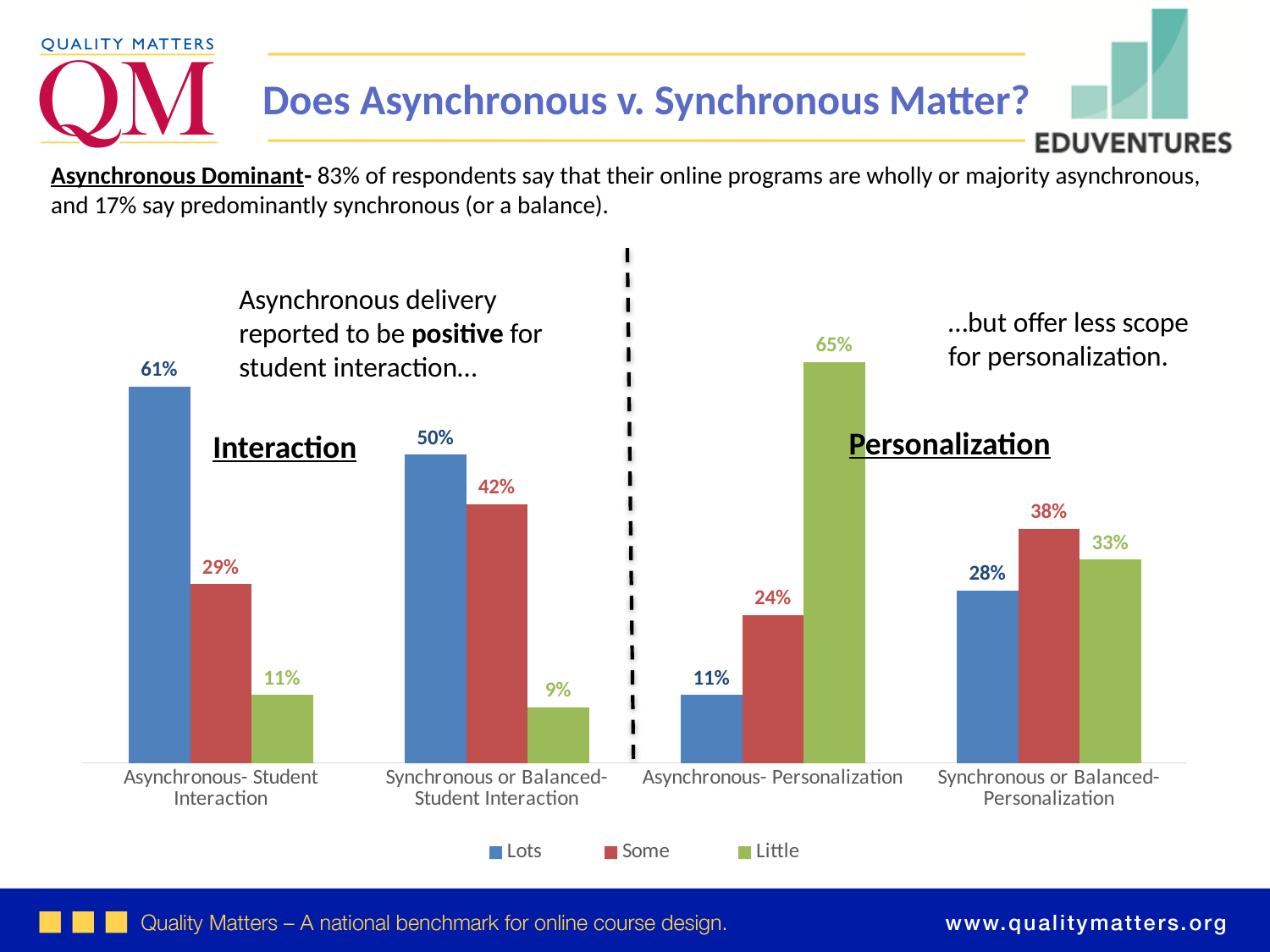
What is the value for Some in the Synchronous or Balanced- Personalization category? 38% Which category has the highest value for Little? Asynchronous- Personalization What is the difference between the Little values for Asynchronous- Personalization and Synchronous or Balanced- Personalization? 32% How many series does the legend list? 3 Which series is shown in green in the legend? Little What is the difference between the Lots values for Asynchronous- Student Interaction and Synchronous or Balanced- Student Interaction? 11% How many categories are shown on the x axis? 4 What kind of chart is shown on the slide? Bar chart Which is larger: Some for Asynchronous- Student Interaction or Some for Synchronous or Balanced- Student Interaction? Synchronous or Balanced- Student Interaction What is the value for Lots in the Asynchronous- Student Interaction category? 61% Which category has the lowest value for Lots? Asynchronous- Personalization What is the value for Little in the Asynchronous- Personalization category? 65%